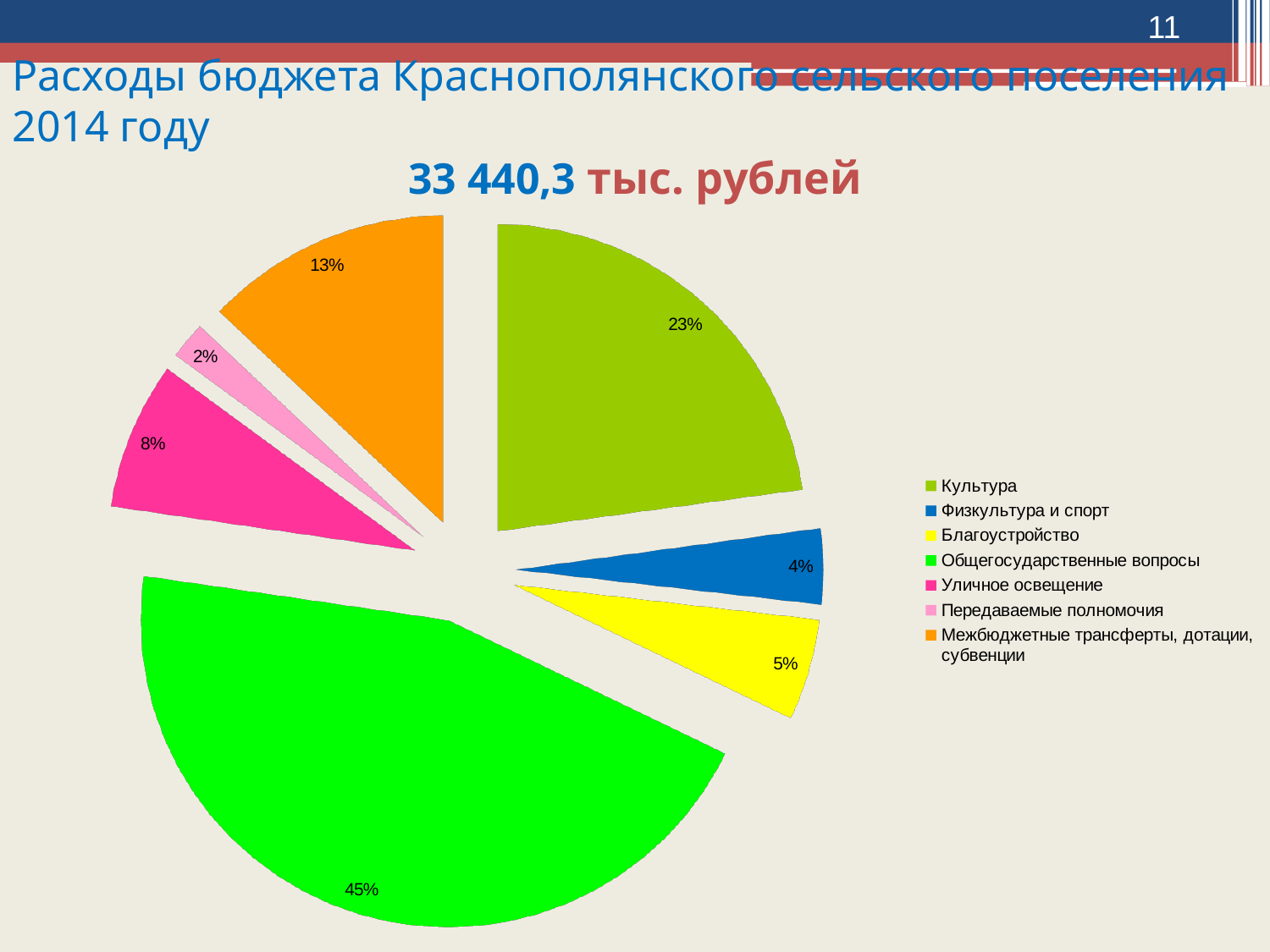
What share of the pie does Культура have? 23% How many categories does the pie chart have? 7 What total amount is shown in the chart title? 33 440,3 тыс. рублей What share of the pie does Межбюджетные трансферты, дотации, субвенции have? 13% What kind of chart is shown on the slide? pie chart What is the difference in percentage points between Общегосударственные вопросы and Культура? 22 What share of the pie does Общегосударственные вопросы have? 45% Which category has the smallest slice of the pie? Передаваемые полномочия Which category has the largest slice of the pie? Общегосударственные вопросы Which is larger, the share for Благоустройство or the share for Физкультура и спорт? Благоустройство